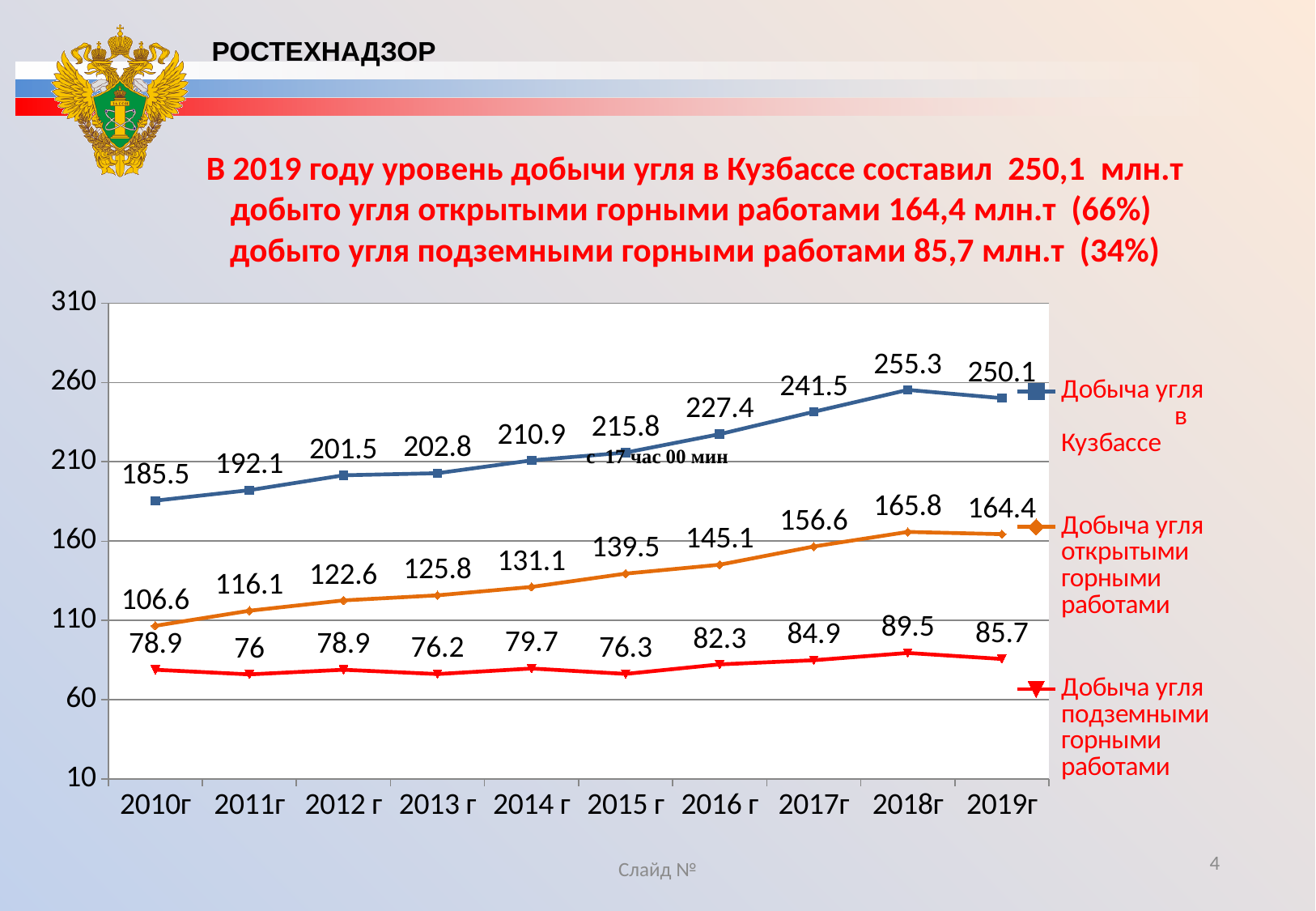
What type of chart is shown on the slide? line chart In which year is "Добыча угля в Кузбассе" highest? 2018г What is the value of "Добыча угля подземными горными работами" for 2011г? 76 In which year is "Добыча угля открытыми горными работами" lowest? 2010г What is the difference between "Добыча угля в Кузбассе" in 2019г and 2010г? 64.6 Which is larger: "Добыча угля подземными горными работами" in 2018г or in 2019г? 2018г How many series does the legend list? 3 Does "Добыча угля открытыми горными работами" generally rise or fall from 2010г to 2018г? rise How many years are shown on the x axis? 10 What colour is the line for "Добыча угля подземными горными работами"? red What is the value of "Добыча угля в Кузбассе" for 2014 г? 210.9 What is the value of "Добыча угля открытыми горными работами" for 2017г? 156.6